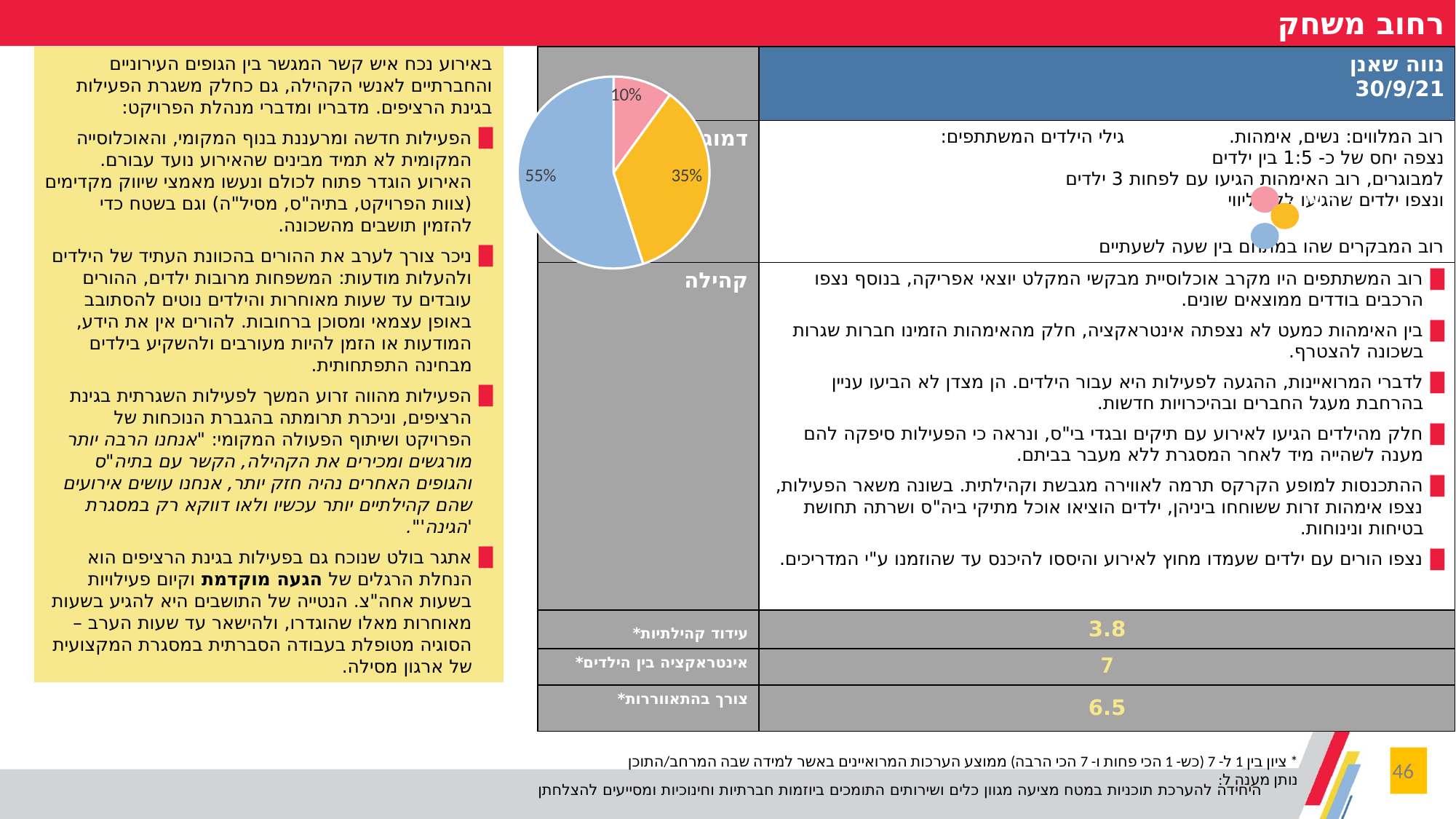
What is the difference between the orange slice and the pink slice of the pie chart? 25% Which slice of the pie chart is the smallest? the pink slice (10%) What percentage is shown on the orange slice of the pie chart? 35% Which slice of the pie chart is the largest? the blue slice (55%) What is the difference between the blue slice and the orange slice of the pie chart? 20% What kind of chart is shown on the slide? pie chart Is the blue slice of the pie chart greater or less than 50%? greater What percentage is shown on the blue slice of the pie chart? 55% How many slices does the pie chart have? 3 What percentage is shown on the pink slice of the pie chart? 10% Which is larger in the pie chart, the orange slice or the pink slice? the orange slice What do the three slices of the pie chart add up to? 100%